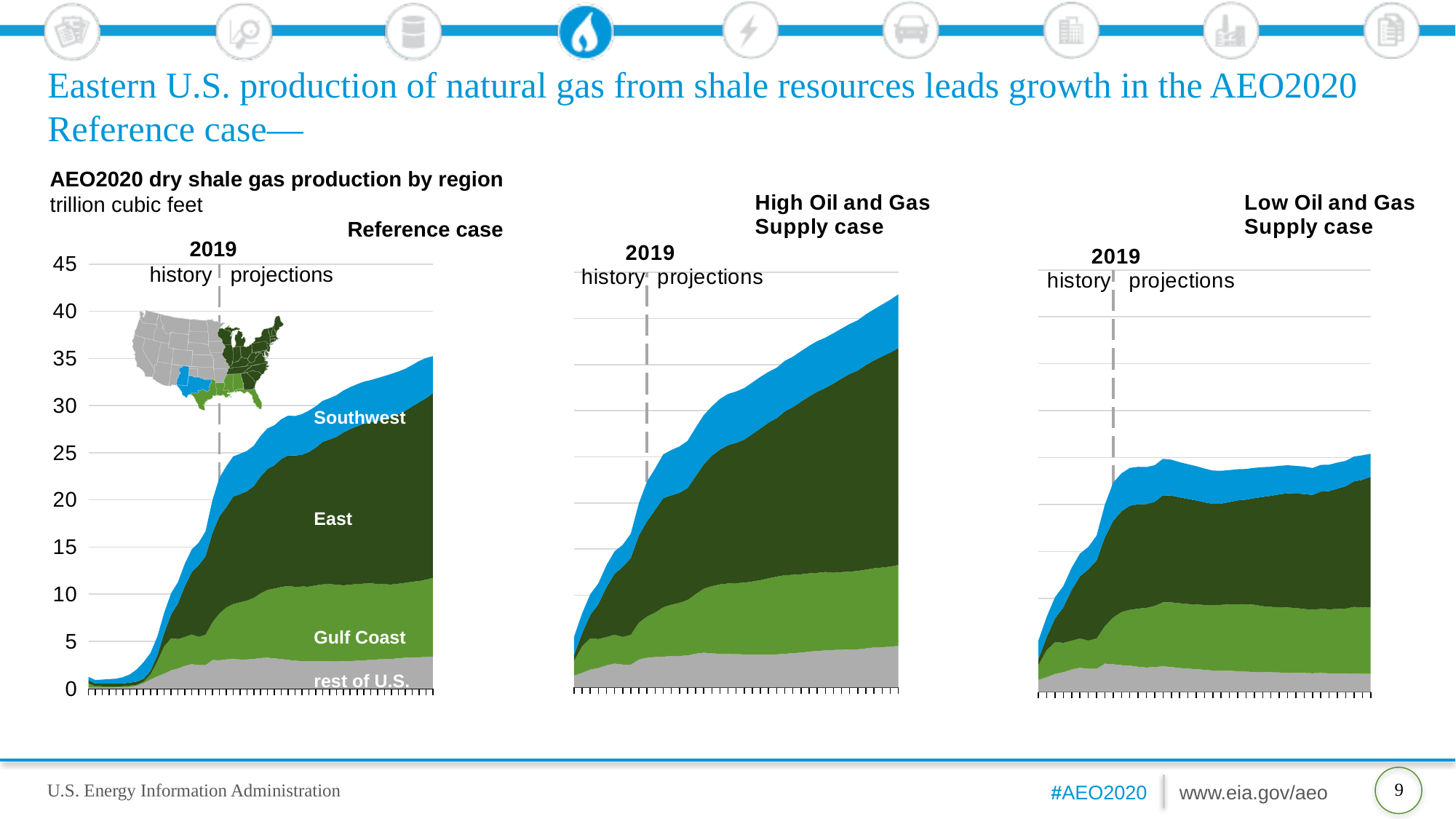
In the Reference case chart, is the total production at the start of the history period greater or less than 5? less In the Reference case chart, does total dry shale gas production rise or fall over the projection period? rise What unit is used on the y axis of the charts? trillion cubic feet In the Reference case chart, which region accounts for the largest share of production in the projection years? East Which of the three charts shows the lowest total production at the end of the projection period? Low Oil and Gas Supply case How many regions are stacked in the Reference case chart? 4 In the Reference case chart, is the total production at the end of the projection period greater or less than 30? greater What year does the dashed vertical line separating history from projections mark? 2019 Which of the three charts shows the highest total production at the end of the projection period? High Oil and Gas Supply case In the Reference case chart, which region accounts for the smallest share of production in the projection years? rest of U.S. What is the title of the chart group on the slide? AEO2020 dry shale gas production by region What kind of chart is the Reference case chart? stacked area chart